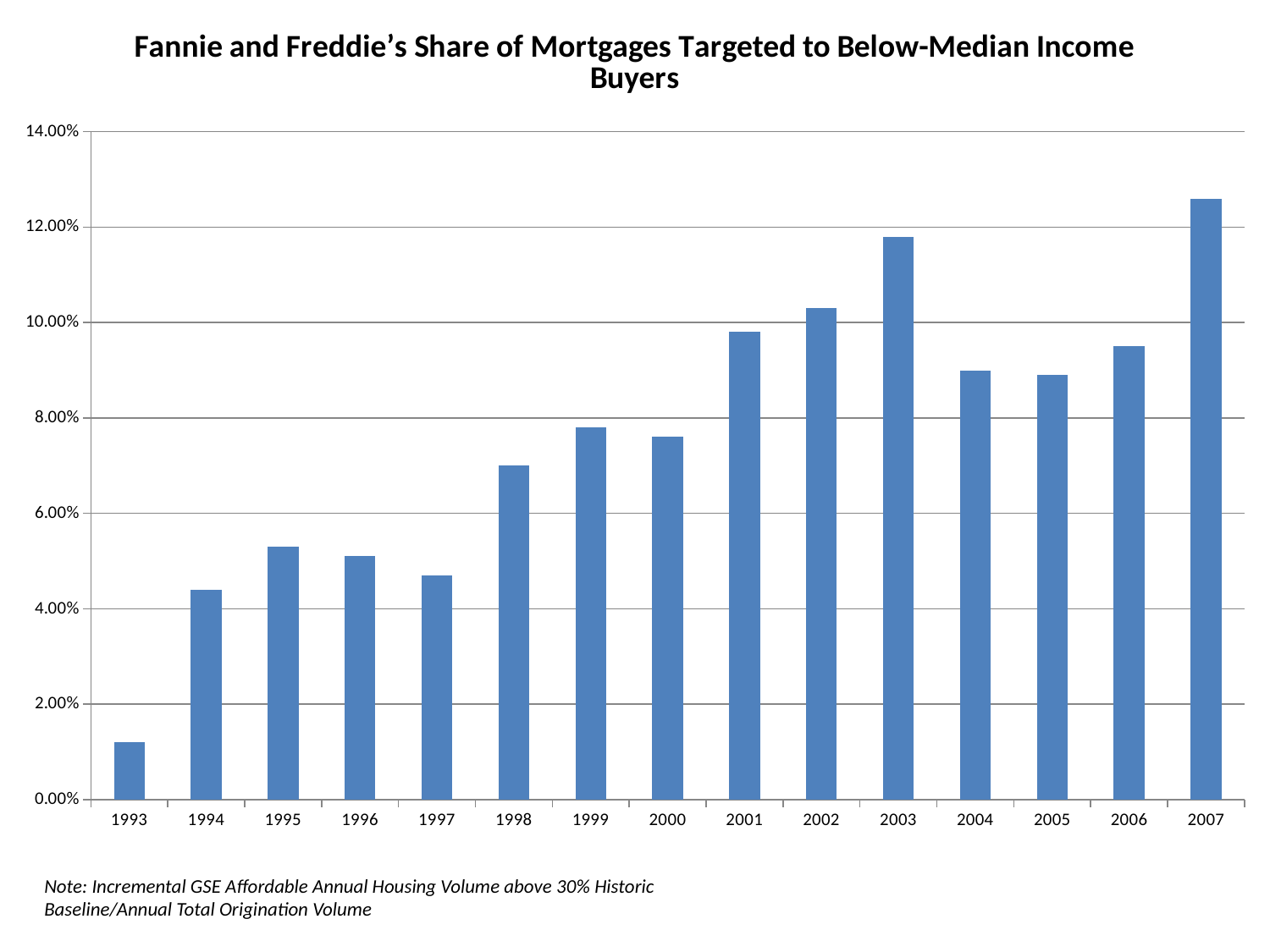
Is the value for 2004 greater or less than 10.00%? less Which year has the highest share? 2007 Is the value for 1997 greater or less than 6.00%? less Which year has the larger share, 2002 or 2003? 2003 Is the value for 1993 greater or less than 2.00%? less Which year has the lowest share? 1993 How many years are plotted on the x axis? 15 What is the title of the chart? Fannie and Freddie's Share of Mortgages Targeted to Below-Median Income Buyers What kind of chart is shown on the slide? bar chart Overall, do the values rise or fall from 1993 to 2007? rise